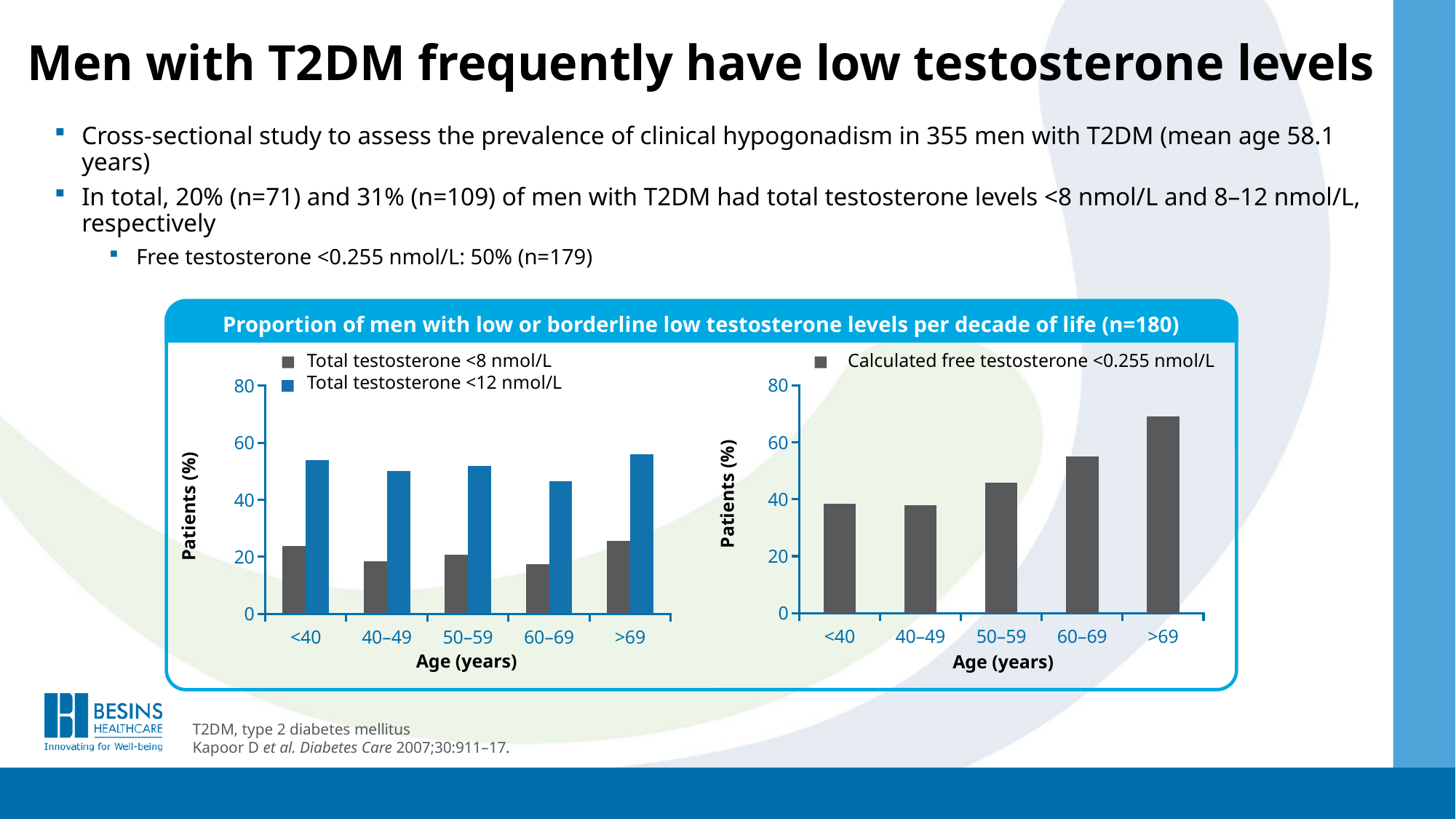
In the right chart (Calculated free testosterone <0.255 nmol/L), which age group has the highest proportion of patients? >69 What type of chart is the left chart (Total testosterone <8 nmol/L and <12 nmol/L)? Bar chart How many series does the legend of the left chart list? 2 In the right chart (Calculated free testosterone <0.255 nmol/L), is the value for the 60–69 age group greater or less than 40? greater In the left chart, is the value for Total testosterone <8 nmol/L in the 60–69 age group greater or less than 20? less In the right chart (Calculated free testosterone <0.255 nmol/L), is the value for the >69 age group greater or less than 60? greater What is the label of the y axis on the left chart? Patients (%) In the left chart, which age group has the lowest value for Total testosterone <12 nmol/L? 60–69 In the right chart (Calculated free testosterone <0.255 nmol/L), which is larger: the value for >69 or the value for <40? >69 How many age categories are shown on the x axis of the right chart (Calculated free testosterone <0.255 nmol/L)? 5 In the right chart (Calculated free testosterone <0.255 nmol/L), do the values generally rise or fall from the <40 group to the >69 group? rise